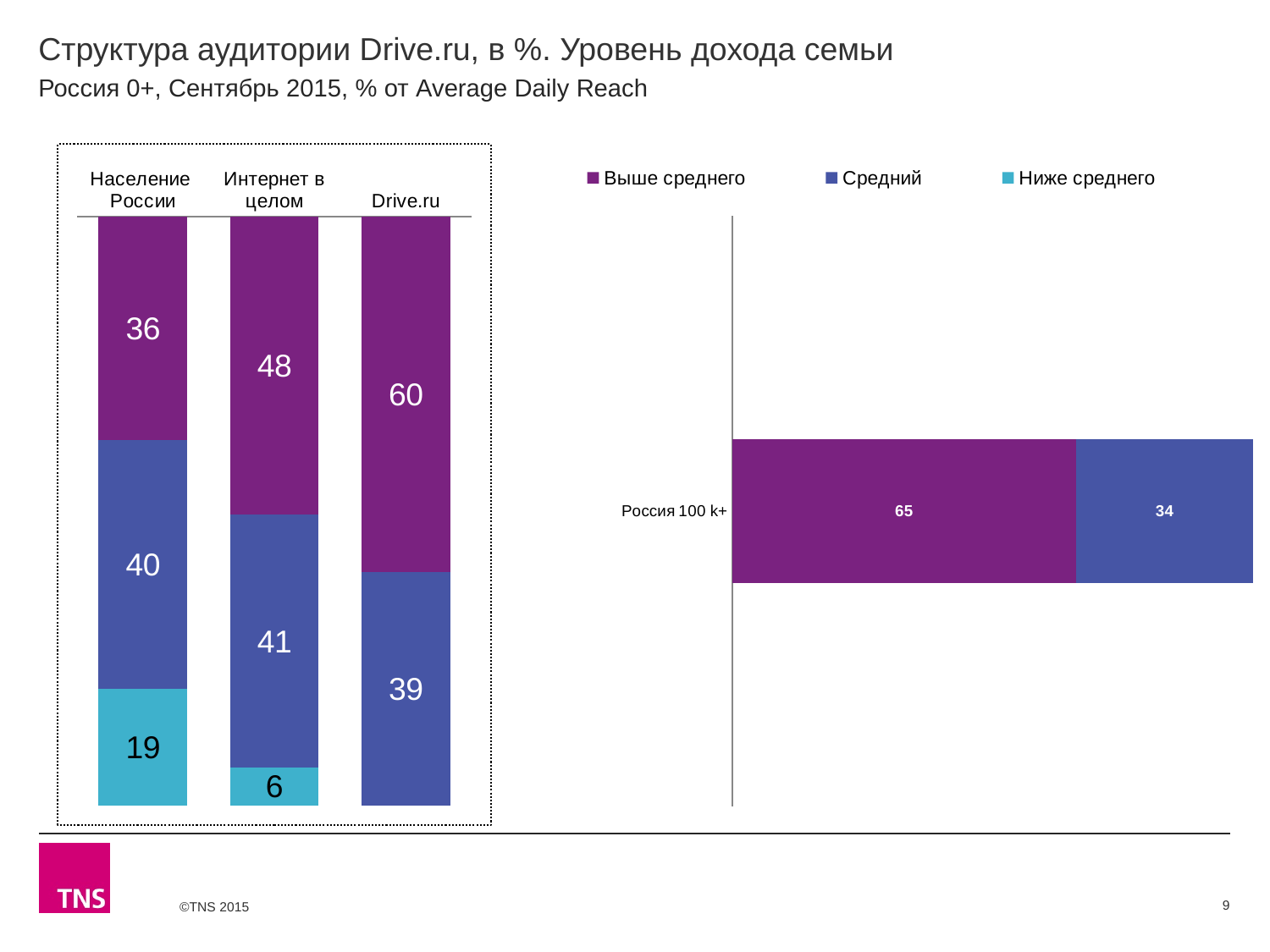
How many series does the legend list? 3 In the left chart, what is the value of the 'Выше среднего' segment for Drive.ru? 60 What type of chart is the right chart? Bar chart In the left chart, which category has the highest 'Выше среднего' value? Drive.ru How many categories are shown in the left chart? 3 In the left chart, what is the difference between the 'Выше среднего' values for Drive.ru and 'Население России'? 24 In the right chart, what is the total of the 'Россия 100 k+' bar? 99 In the left chart, which is larger: the 'Средний' value for 'Население России' or for Drive.ru? Население России In the left chart, what is the value of the 'Ниже среднего' segment for 'Население России'? 19 In the right chart, what is the 'Выше среднего' value for 'Россия 100 k+'? 65 In the left chart, what is the value of the 'Средний' segment for 'Интернет в целом'? 41